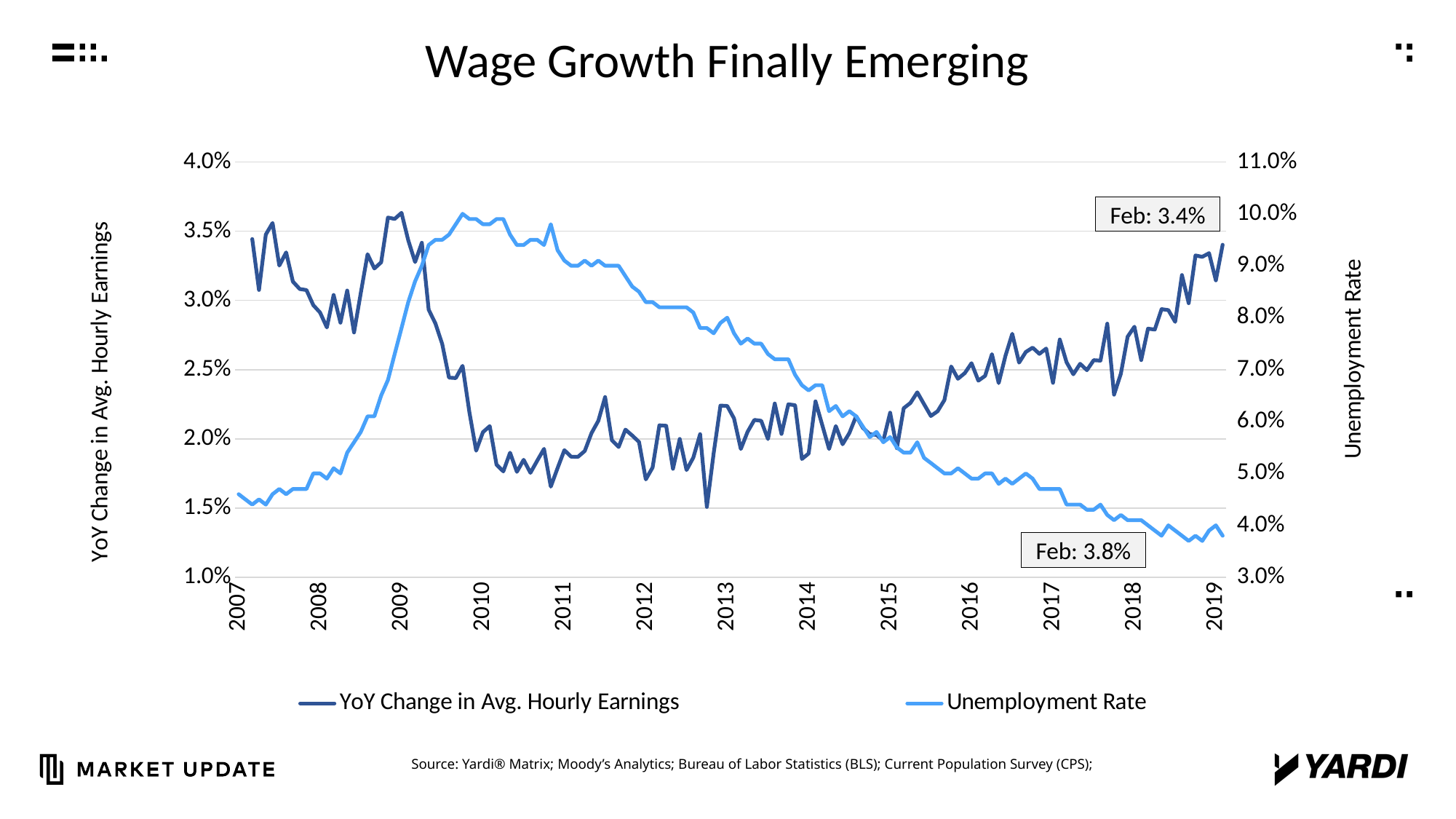
Which of the two labelled February values is larger, the YoY Change in Avg. Hourly Earnings or the Unemployment Rate? Unemployment Rate Is the Unemployment Rate at the start of 2007 greater or less than 5.0%? less What is the title of the chart? Wage Growth Finally Emerging Does the Unemployment Rate rise or fall from 2010 to 2019? fall How many series does the legend list? 2 What is the labelled February 2019 value for YoY Change in Avg. Hourly Earnings? 3.4% What kind of chart is shown on the slide? line chart Does the YoY Change in Avg. Hourly Earnings rise or fall from 2015 to 2019? rise Is the YoY Change in Avg. Hourly Earnings during 2012 greater or less than 2.5%? less Is the Unemployment Rate at the start of 2010 greater or less than 9.0%? greater What is the label on the right-hand vertical axis? Unemployment Rate What is the labelled February 2019 value for the Unemployment Rate? 3.8%